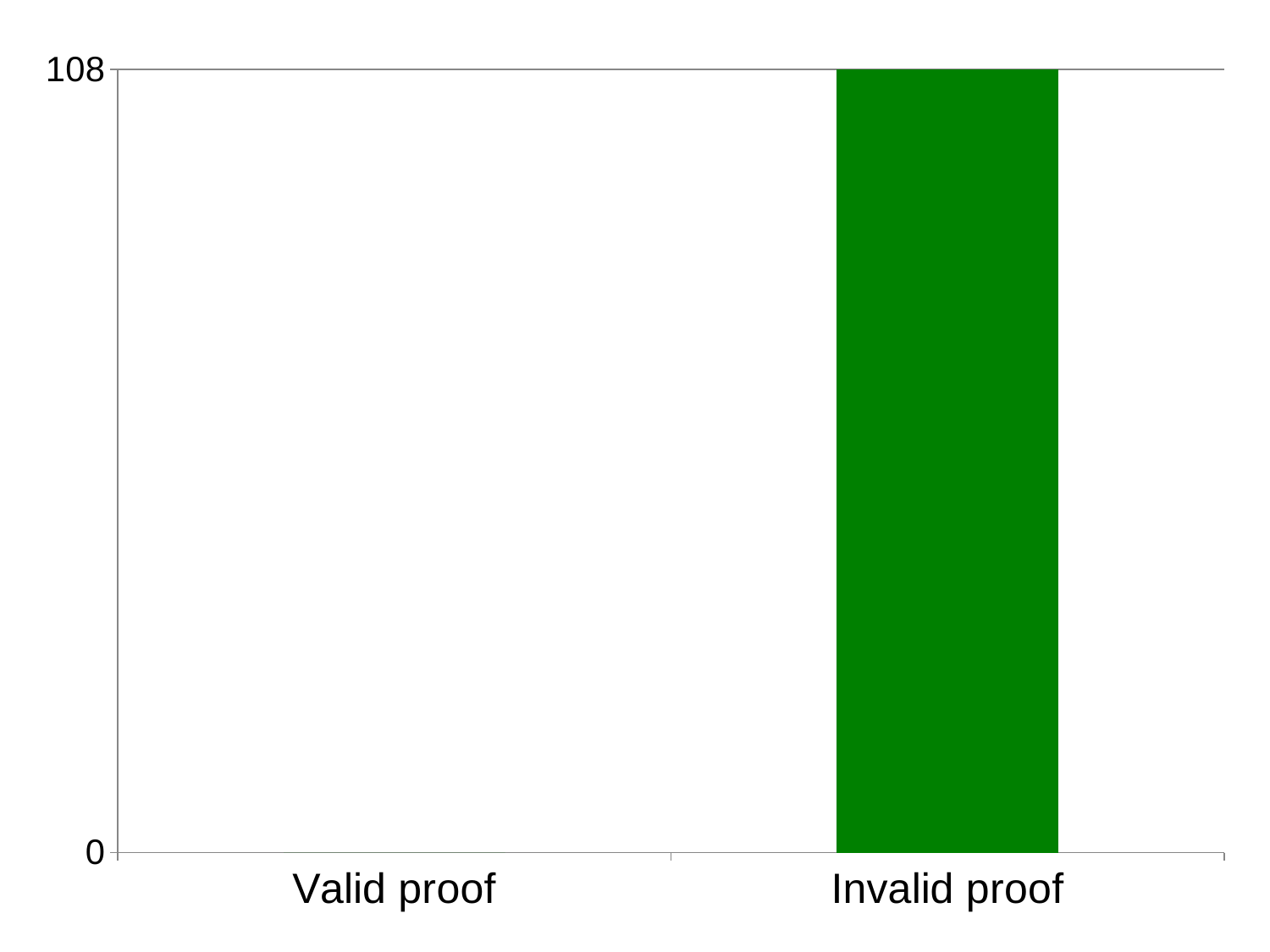
What is the value for Valid proof? 0 What is the highest value labelled on the y axis? 108 What kind of chart is shown on the slide? bar chart Do the values rise or fall from Valid proof to Invalid proof? rise Which category has the lowest value? Valid proof What is the difference between the value for Invalid proof and the value for Valid proof? 108 How many categories are shown on the x axis? 2 What is the value for Invalid proof? 108 Which is larger, the value for Valid proof or the value for Invalid proof? Invalid proof Which category has the highest value? Invalid proof What colour is the bar for Invalid proof? green